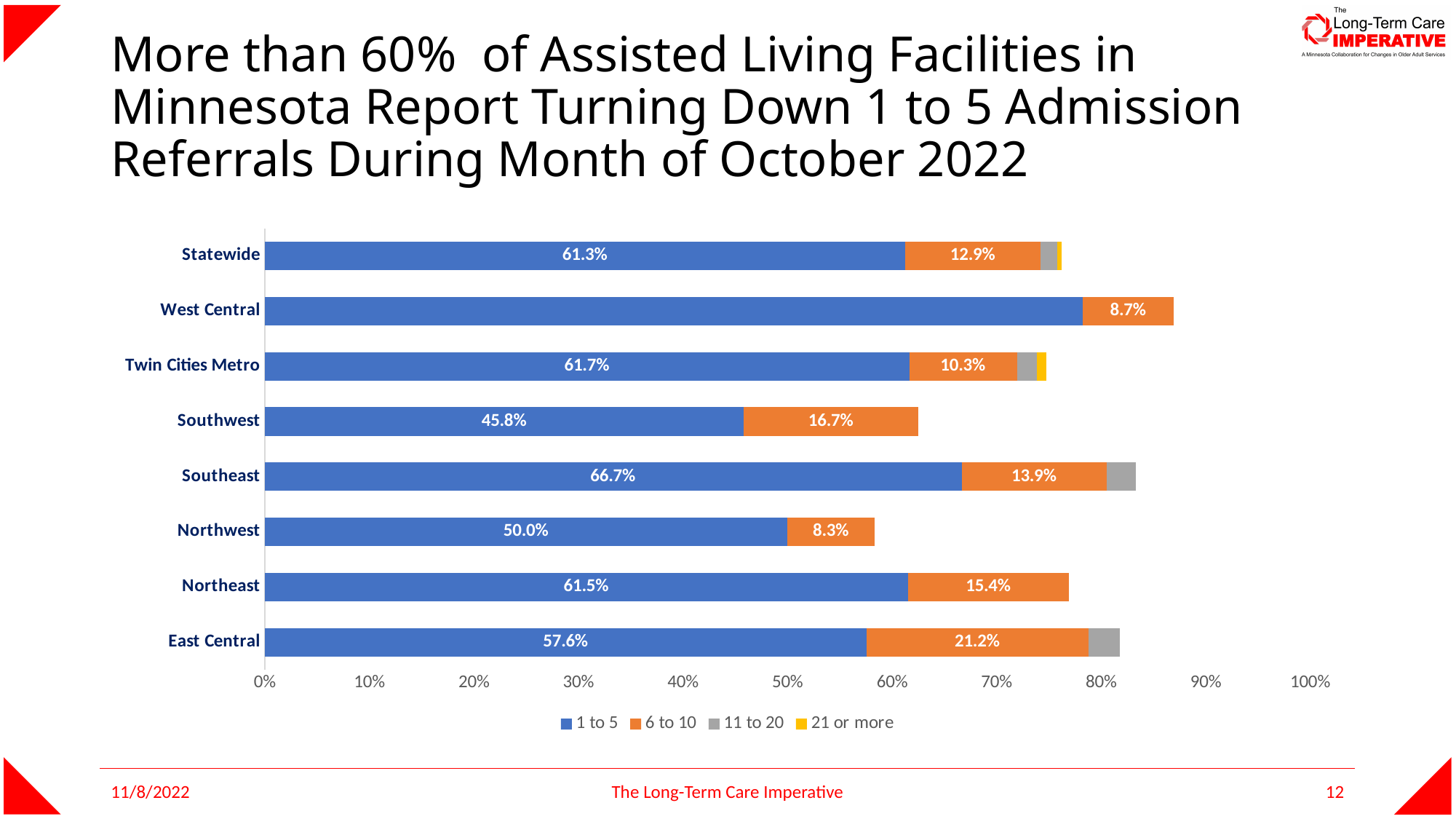
What is the difference between the '6 to 10' values for Southwest and Northwest? 8.4 percentage points What percentage of Statewide assisted living facilities reported turning down 1 to 5 admission referrals? 61.3% What is the '6 to 10' value for West Central? 8.7% Which has a larger '1 to 5' value, Southeast or Twin Cities Metro? Southeast How many series does the legend list? 4 What is the '1 to 5' value for Southwest? 45.8% Is the '1 to 5' value for West Central greater or less than 70%? greater Which region has the highest '6 to 10' value? East Central Which region has the lowest '1 to 5' value? Southwest How many regions (categories) are shown on the chart? 8 What is the value of the '6 to 10' segment for East Central? 21.2% What kind of chart is shown on the slide? Stacked bar chart